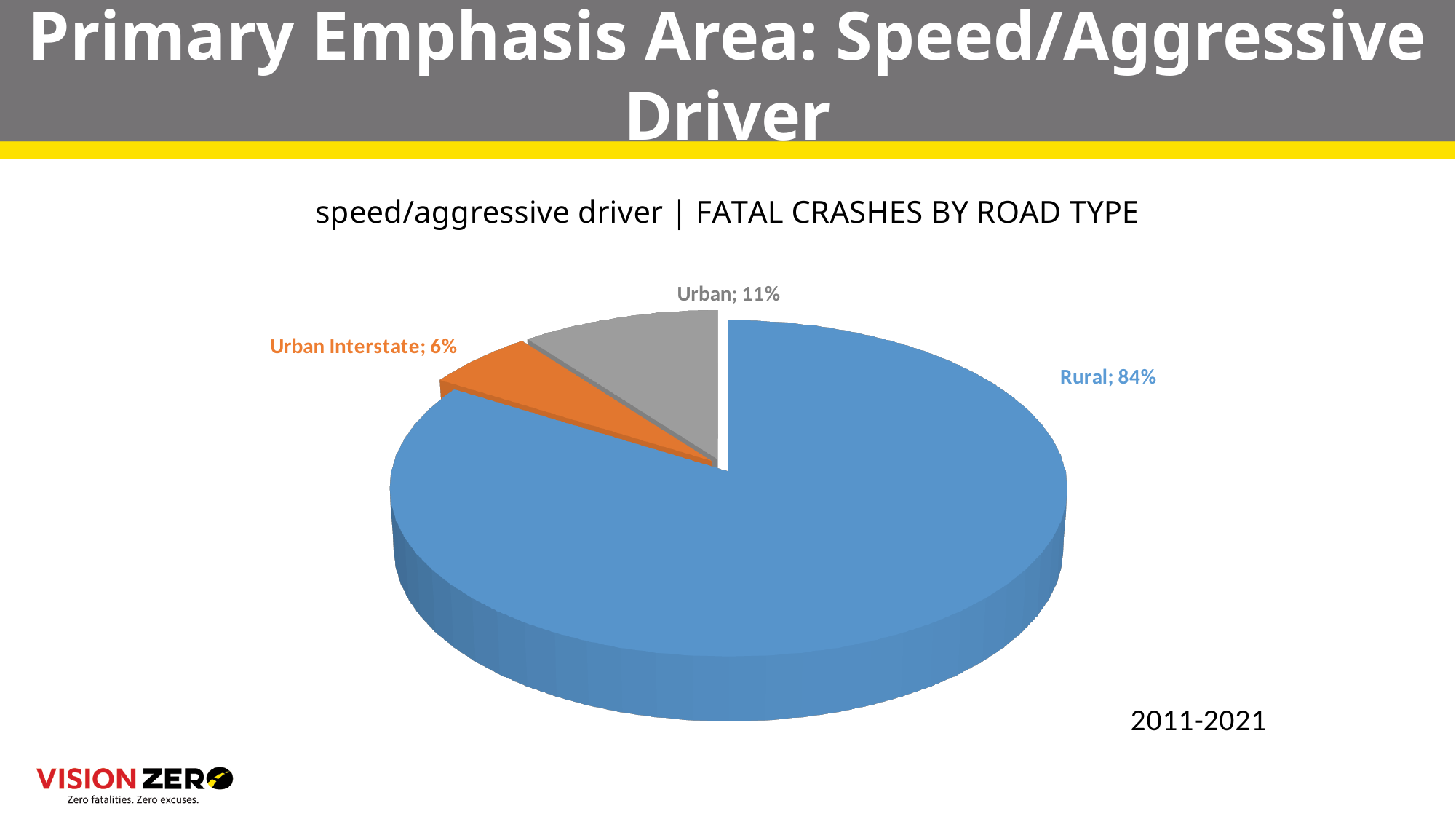
Which road type has the largest share of fatal crashes in the pie chart? Rural What share of speed/aggressive driver fatal crashes occurred on Rural roads? 84% What share of speed/aggressive driver fatal crashes occurred on Urban Interstate roads? 6% Which has a larger share of fatal crashes, Urban or Urban Interstate? Urban What kind of chart is shown on the slide? Pie chart How many percentage points larger is the Urban share than the Urban Interstate share? 5 What is the title of the chart? speed/aggressive driver | FATAL CRASHES BY ROAD TYPE What time period does the chart cover, according to the label on the slide? 2011-2021 How many percentage points larger is the Rural share than the Urban share? 73 What share of speed/aggressive driver fatal crashes occurred on Urban roads? 11% How many road type categories are shown in the pie chart? 3 Which road type has the smallest share of fatal crashes in the pie chart? Urban Interstate